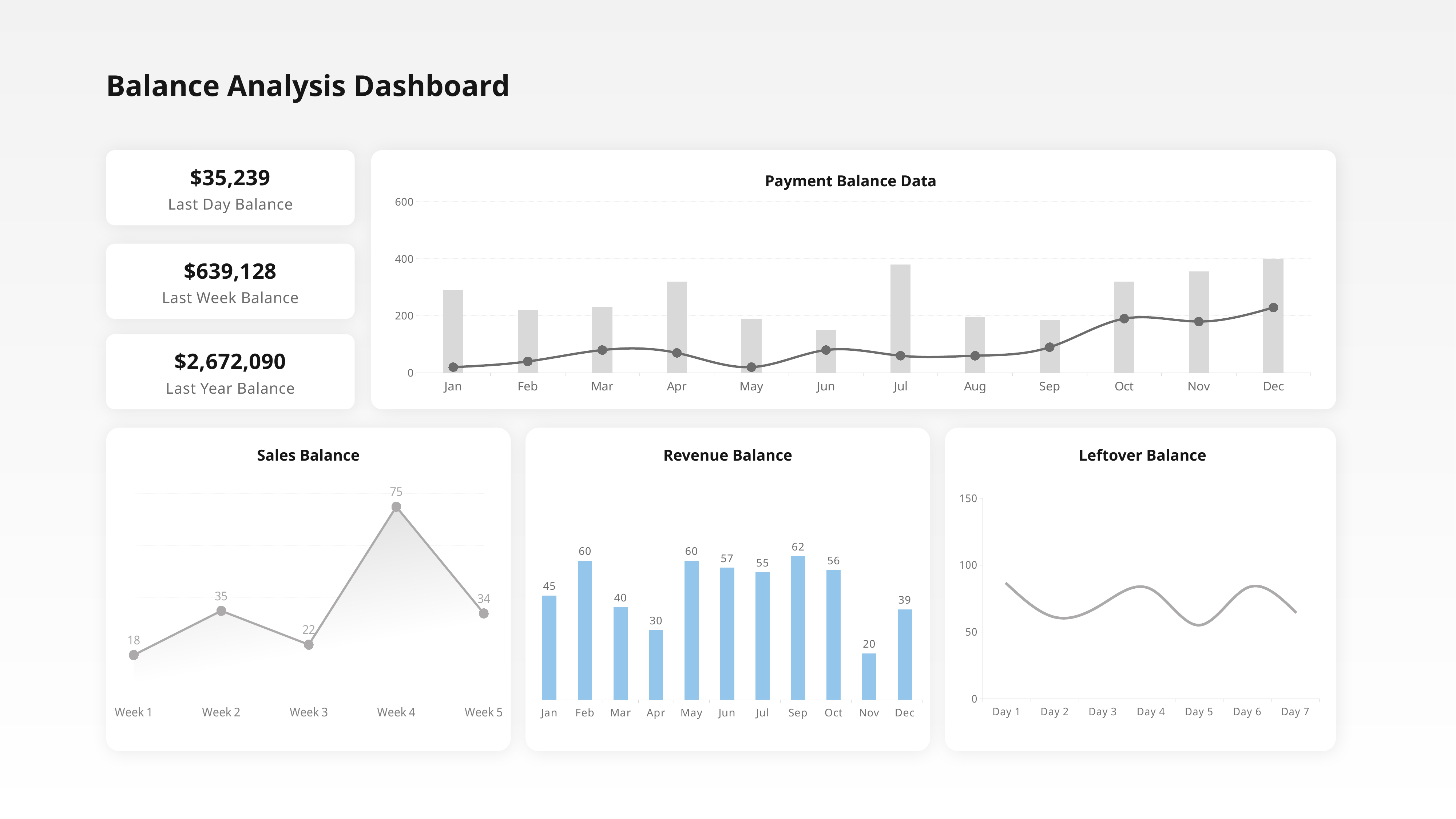
In the Revenue Balance chart, what is the value for Sep? 62 In the Payment Balance Data chart, is the bar for Jul greater or less than 200? greater In the Sales Balance chart, what is the difference between the values for Week 4 and Week 2? 40 In the Revenue Balance chart, which month has the lowest value? Nov How many months are shown on the x axis of the Revenue Balance chart? 11 In the Sales Balance chart, what is the value for Week 4? 75 In the Sales Balance chart, which week has the highest value? Week 4 In the Revenue Balance chart, which is larger, the value for Jan or the value for Apr? Jan What kind of chart is the Revenue Balance chart? Bar chart In the Sales Balance chart, which week has the lowest value? Week 1 In the Leftover Balance chart, is the value for Day 5 greater or less than 100? less In the Revenue Balance chart, what is the difference between the values for Feb and Nov? 40